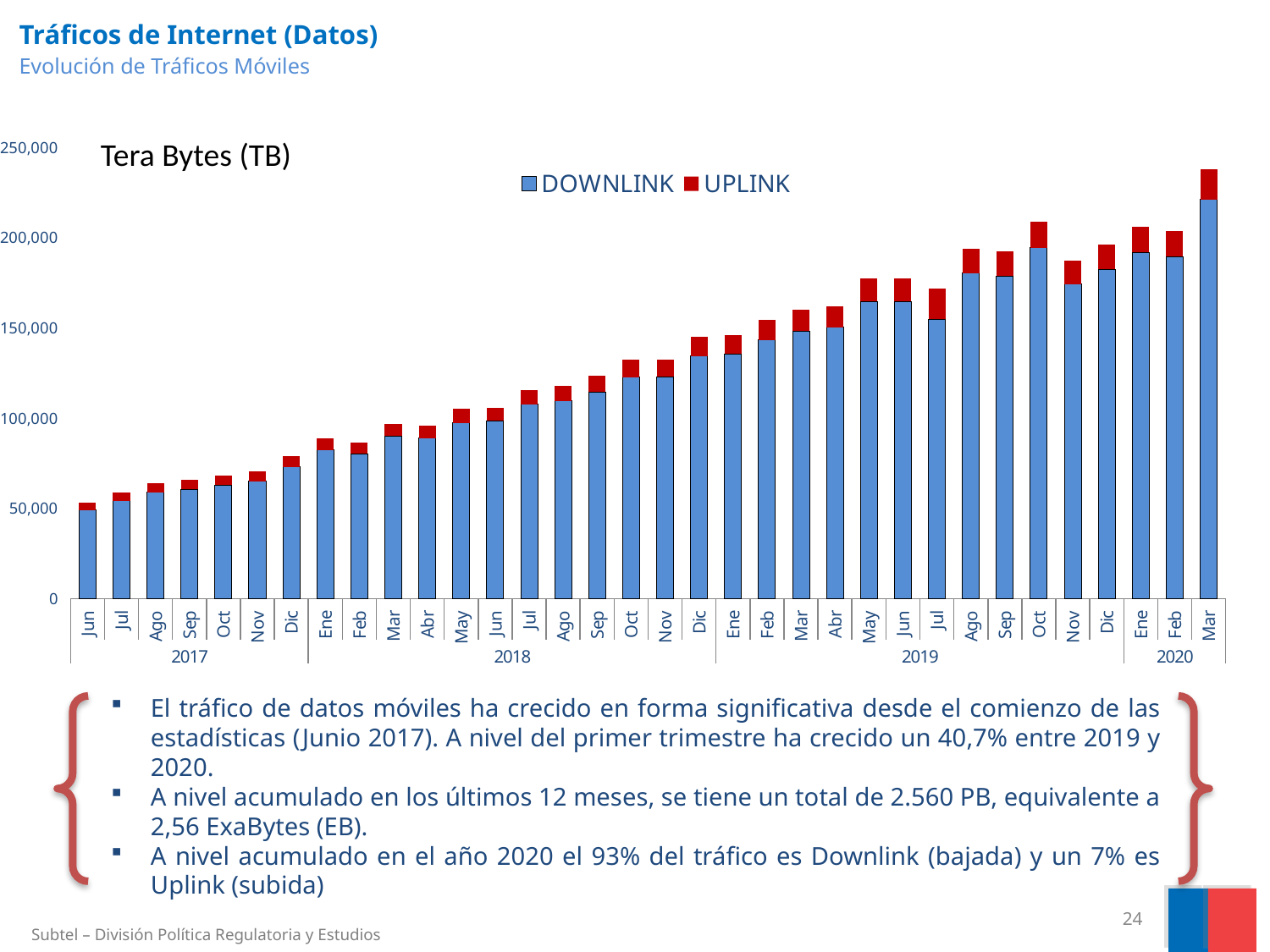
Is the total traffic for Dic 2017 greater or less than 100,000? less Is the DOWNLINK value for Dic 2018 greater or less than 150,000? less How many monthly bars are plotted in the chart? 34 Which month has the higher total traffic, Oct 2019 or Nov 2019? Oct 2019 Which month has the highest total traffic in the chart? Mar 2020 What kind of chart is shown on the slide? Stacked bar chart How many series does the chart legend list? 2 What unit of measurement is indicated for the chart values? Tera Bytes (TB) Is the total traffic for Mar 2020 greater or less than 200,000? greater Which two series are listed in the chart legend? DOWNLINK and UPLINK Do the total traffic values generally rise or fall from Jun 2017 to Mar 2020? Rise Which month has the lowest total traffic in the chart? Jun 2017